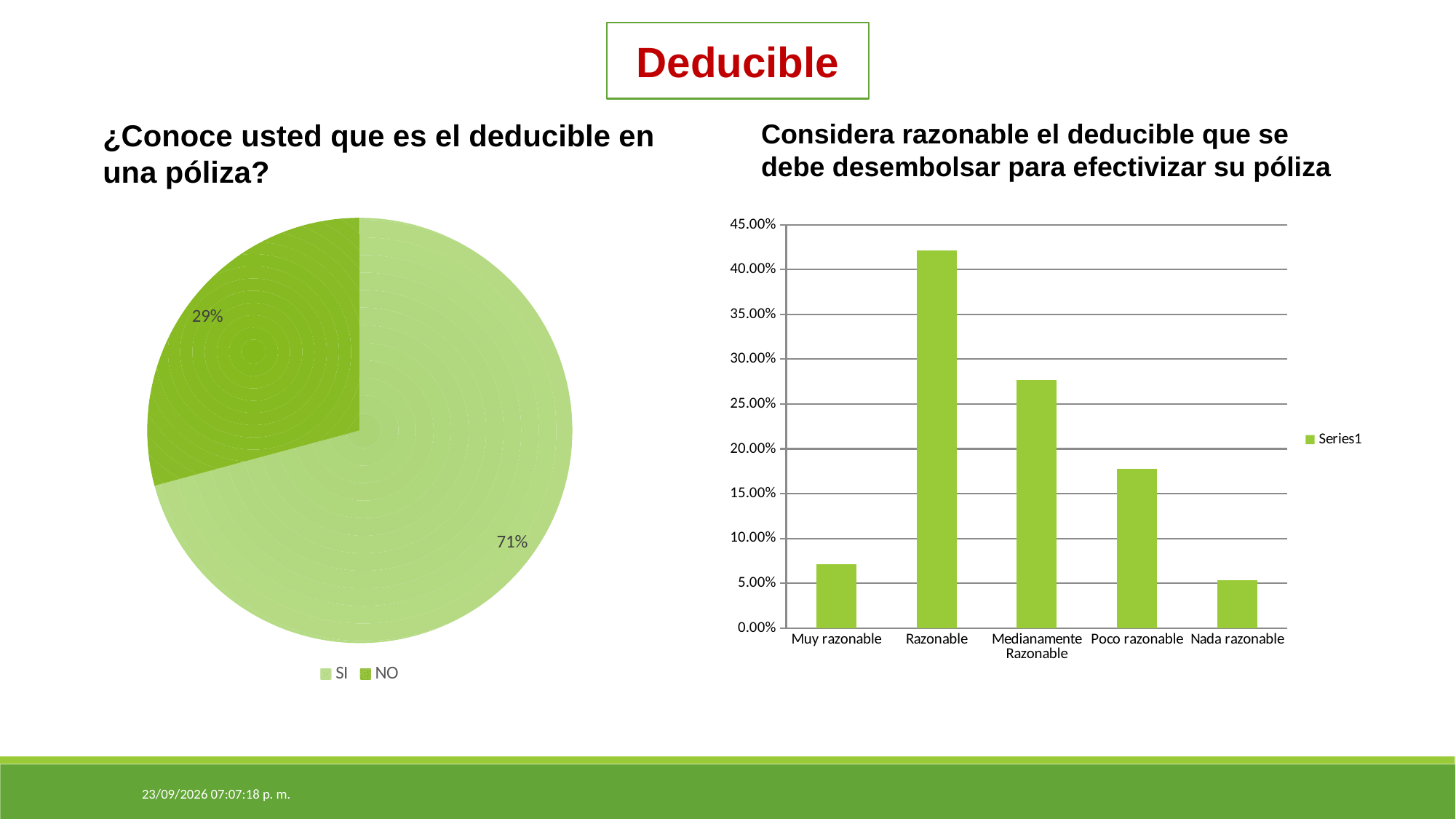
In the pie chart on the left, what percentage of respondents answered NO? 29% In the bar chart on the right, which category has the highest value? Razonable In the pie chart on the left, what is the difference between the SI and NO shares? 42% What kind of chart is the chart on the left? Pie chart In the bar chart on the right, which is larger, the value for Medianamente Razonable or the value for Poco razonable? Medianamente Razonable In the bar chart on the right, how many categories are shown on the x axis? 5 What kind of chart is the chart on the right? Bar chart In the pie chart on the left, what percentage of respondents answered SI? 71% In the bar chart on the right, is the value for Razonable greater or less than 40.00%? greater In the bar chart on the right, which category has the lowest value? Nada razonable In the pie chart on the left, which answer has the larger share, SI or NO? SI In the bar chart on the right, is the value for Muy razonable greater or less than 10.00%? less